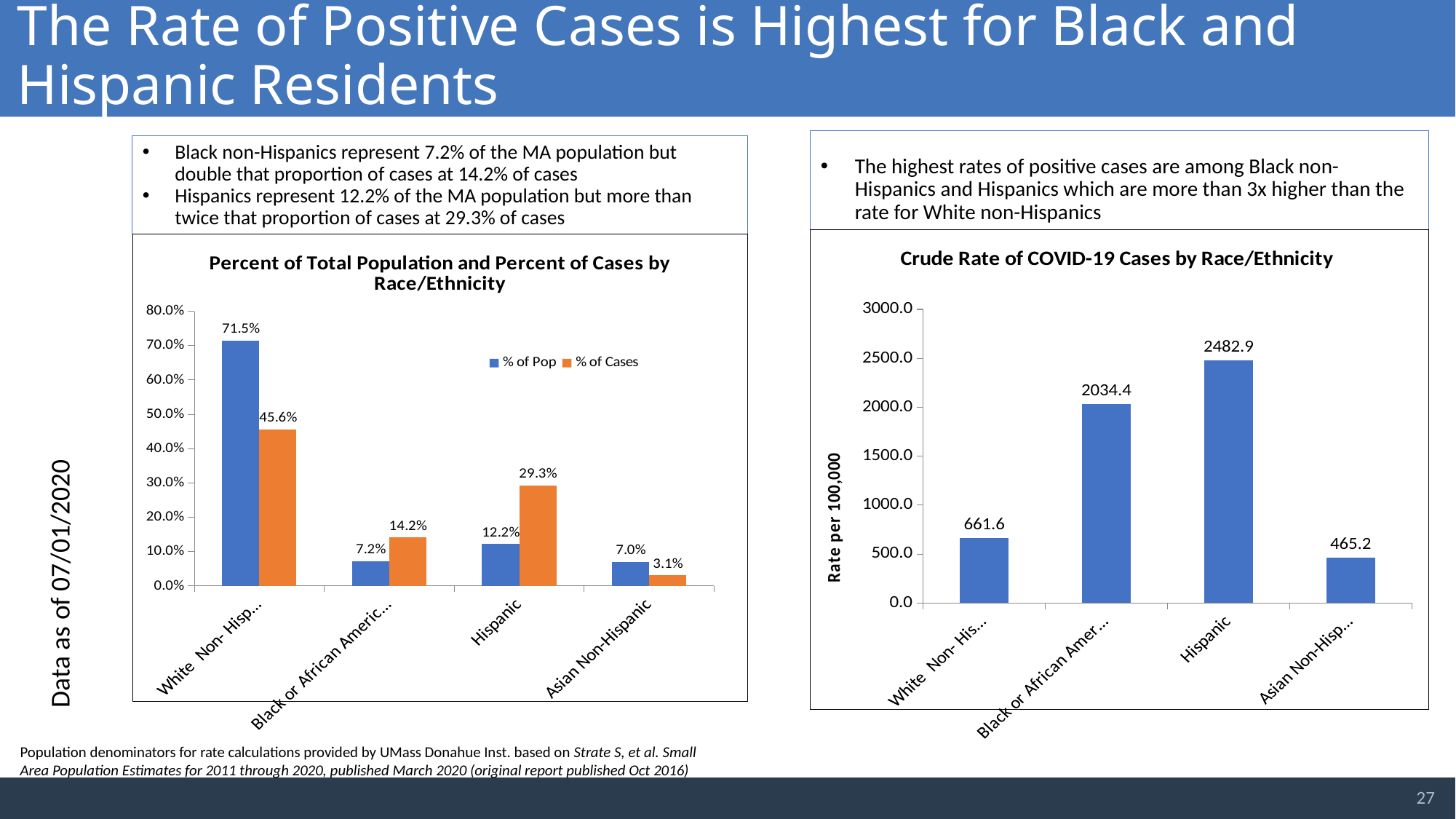
In the 'Crude Rate of COVID-19 Cases by Race/Ethnicity' chart, which category has the lowest rate? Asian Non-Hispanic In the 'Crude Rate of COVID-19 Cases by Race/Ethnicity' chart, how many categories are plotted? 4 What kind of chart is the 'Crude Rate of COVID-19 Cases by Race/Ethnicity' chart? Bar chart In the 'Percent of Total Population and Percent of Cases by Race/Ethnicity' chart, what is the % of Cases value for Hispanic? 29.3% What is the y-axis label of the 'Crude Rate of COVID-19 Cases by Race/Ethnicity' chart? Rate per 100,000 In the 'Percent of Total Population and Percent of Cases by Race/Ethnicity' chart, which is larger for Asian Non-Hispanic: % of Pop or % of Cases? % of Pop In the 'Percent of Total Population and Percent of Cases by Race/Ethnicity' chart, what is the % of Pop value for White Non-Hispanic? 71.5% In the 'Crude Rate of COVID-19 Cases by Race/Ethnicity' chart, what is the difference between the Hispanic rate and the White Non-Hispanic rate? 1821.3 In the 'Percent of Total Population and Percent of Cases by Race/Ethnicity' chart, what is the difference between % of Cases and % of Pop for Hispanic? 17.1% In the 'Crude Rate of COVID-19 Cases by Race/Ethnicity' chart, what is the rate for Hispanic residents? 2482.9 In the 'Percent of Total Population and Percent of Cases by Race/Ethnicity' chart, how many series does the legend list? 2 In the 'Crude Rate of COVID-19 Cases by Race/Ethnicity' chart, which category has the highest rate? Hispanic